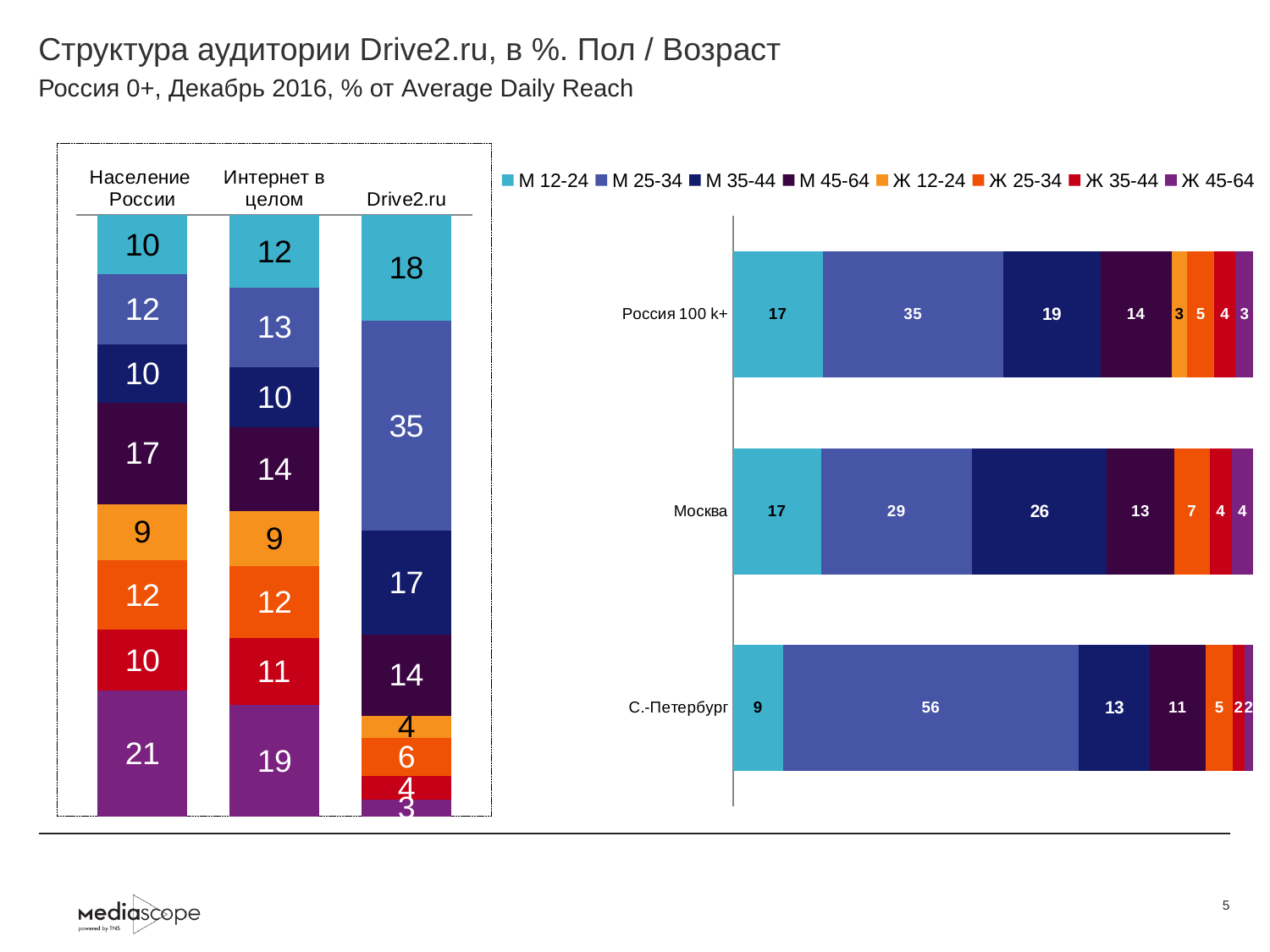
In the left chart, what is the value for М 45-64 in the Интернет в целом column? 14 In the right chart, which is larger: М 35-44 for Москва or М 35-44 for Россия 100 k+? Москва What kind of chart is the right chart? Stacked bar chart In the left chart, what is the value for Ж 45-64 in the Население России column? 21 In the right chart, what is the value for М 35-44 for Москва? 26 How many series does the legend of the right chart list? 8 In the right chart, which segment is the largest for Россия 100 k+? М 25-34 In the left chart, what is the value for М 25-34 in the Drive2.ru column? 35 How many categories are shown on the right chart? 3 In the right chart, what is the value for М 25-34 for С.-Петербург? 56 In the left chart, which segment is the smallest in the Drive2.ru column? Ж 45-64 In the left chart, what is the difference between the М 25-34 values for Drive2.ru and Население России? 23